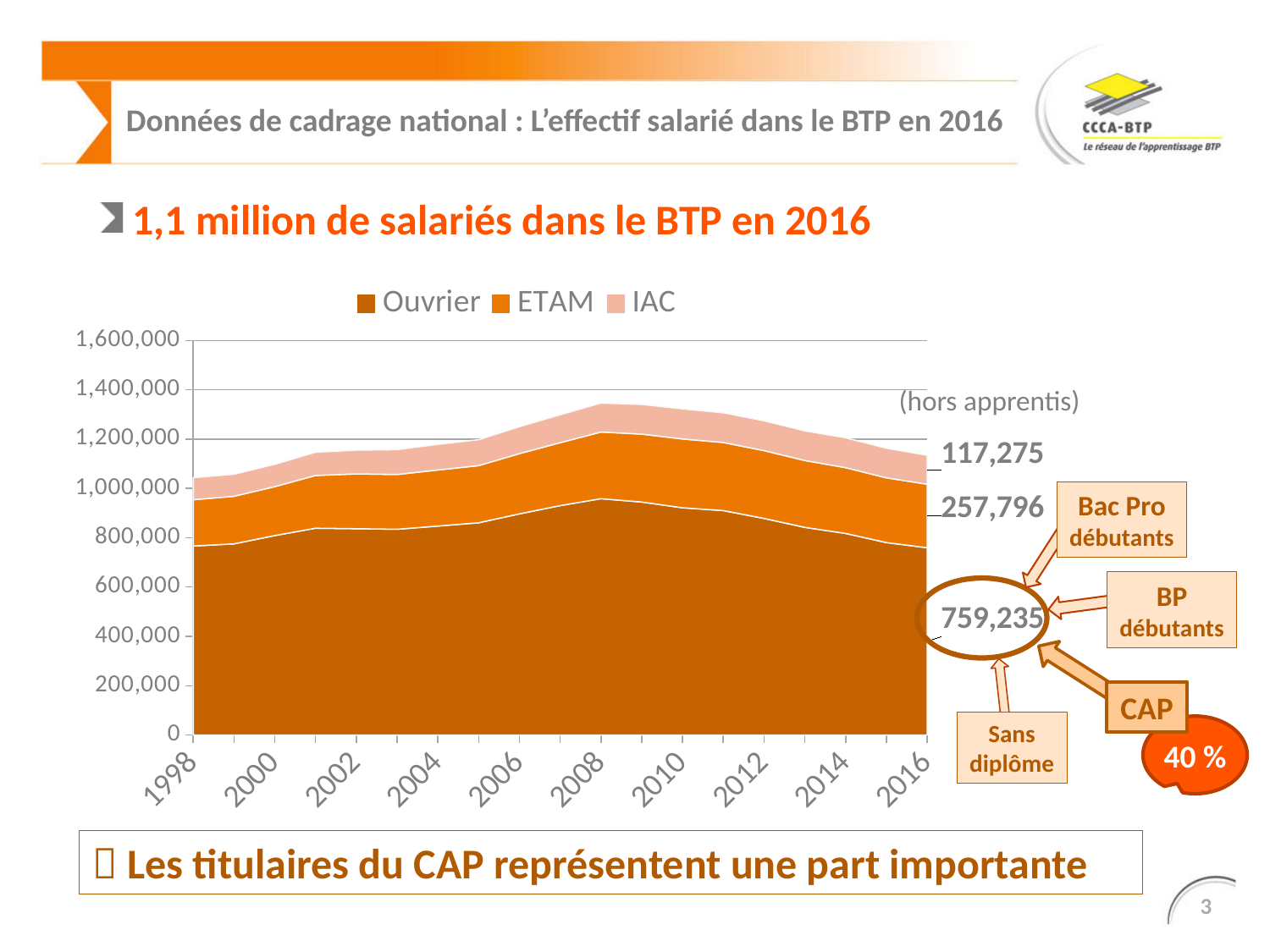
Which series has the lowest value in 2016? IAC Is the value for Ouvrier in 2008 greater or less than 800,000? greater What is the value for IAC in 2016? 117,275 How many series does the legend list? 3 Which series has the highest value in 2016? Ouvrier Which is larger in 2016, ETAM or IAC? ETAM What is the value for Ouvrier in 2016? 759,235 What kind of chart is shown? Area chart What is the value for ETAM in 2016? 257,796 What is the total of the three series in 2016? 1,134,306 What is the difference between the Ouvrier and ETAM values in 2016? 501,439 Does the total stacked value rise or fall from 2008 to 2016? Fall